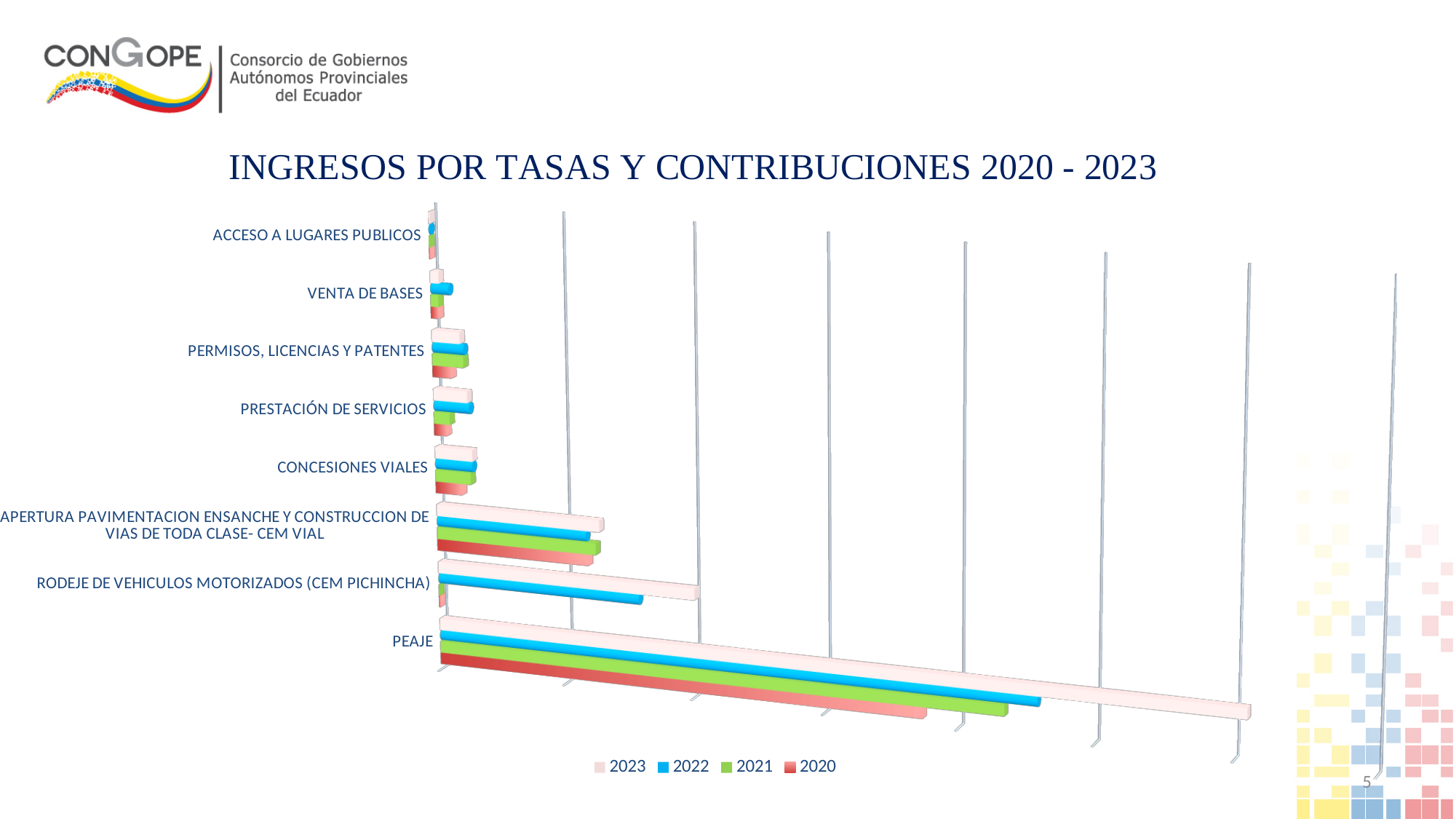
How many categories are shown on the chart? 8 Which category has the lowest values overall? ACCESO A LUGARES PUBLICOS For PEAJE, which year has the largest value? 2023 Which category has the larger 2023 value: PEAJE or CONCESIONES VIALES? PEAJE For PEAJE, which year has the smallest value? 2020 Which years are listed in the legend? 2023, 2022, 2021, 2020 Which category has the highest values overall? PEAJE What kind of chart is shown on the slide? Bar chart For PEAJE, do the values rise or fall from 2020 to 2023? Rise For RODEJE DE VEHICULOS MOTORIZADOS (CEM PICHINCHA), which is larger: the 2023 value or the 2022 value? 2023 How many series does the legend list? 4 What is the title of the chart? INGRESOS POR TASAS Y CONTRIBUCIONES 2020 - 2023